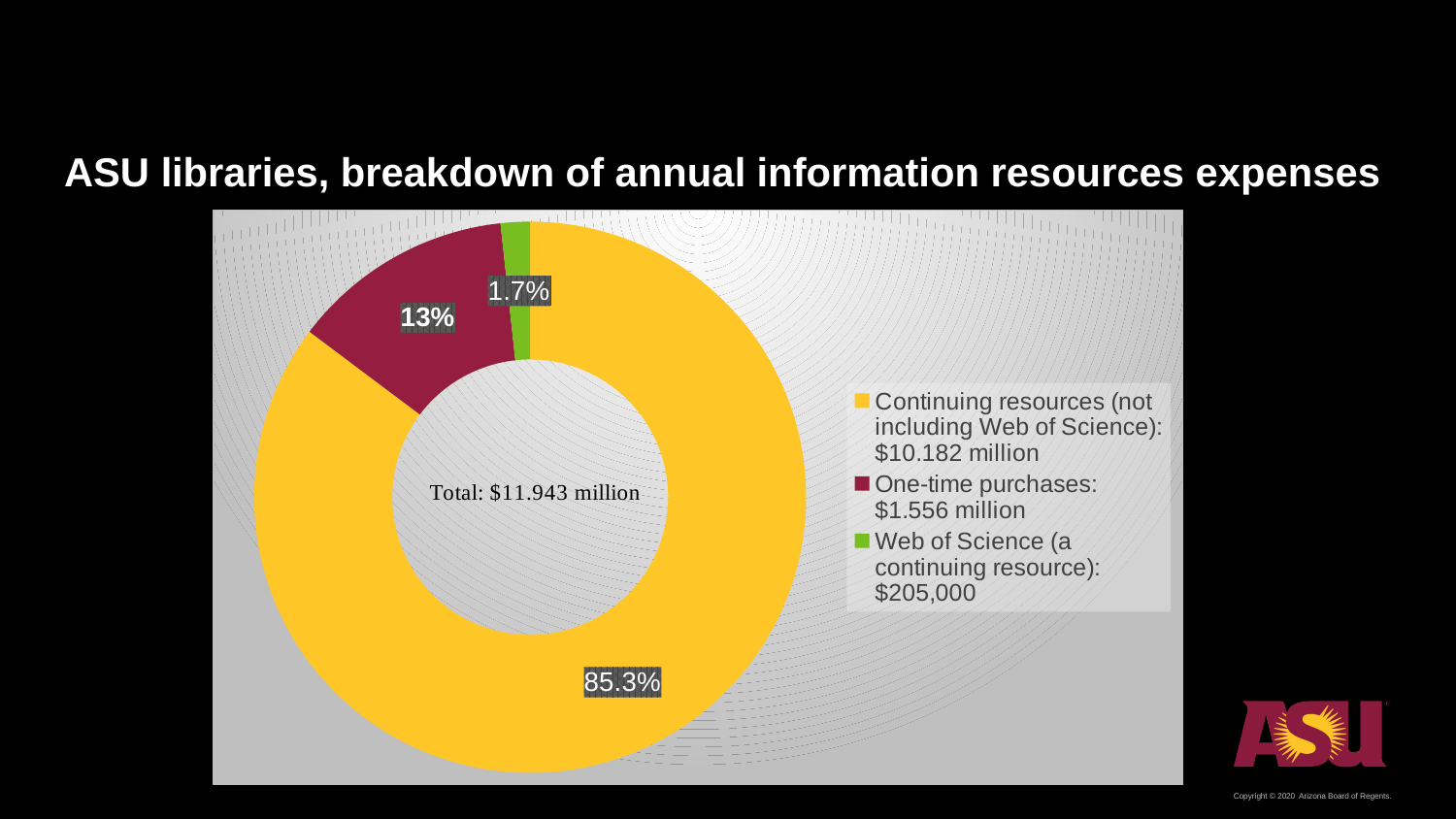
Which category accounts for the smallest share of expenses? Web of Science (a continuing resource) What share of the expenses is Web of Science? 1.7% How many categories does the chart show? 3 What share of the expenses is one-time purchases? 13% What colour is the slice for one-time purchases? Maroon According to the legend, how much is spent on Web of Science? $205,000 Which category accounts for the largest share of expenses? Continuing resources (not including Web of Science) What is the total annual information resources expense shown in the centre of the chart? $11.943 million According to the legend, how much is spent on one-time purchases? $1.556 million What share of annual information resources expenses goes to continuing resources (not including Web of Science)? 85.3% What kind of chart is shown on the slide? Doughnut (pie) chart What is the difference in percentage points between the continuing resources share and the one-time purchases share? 72.3 percentage points